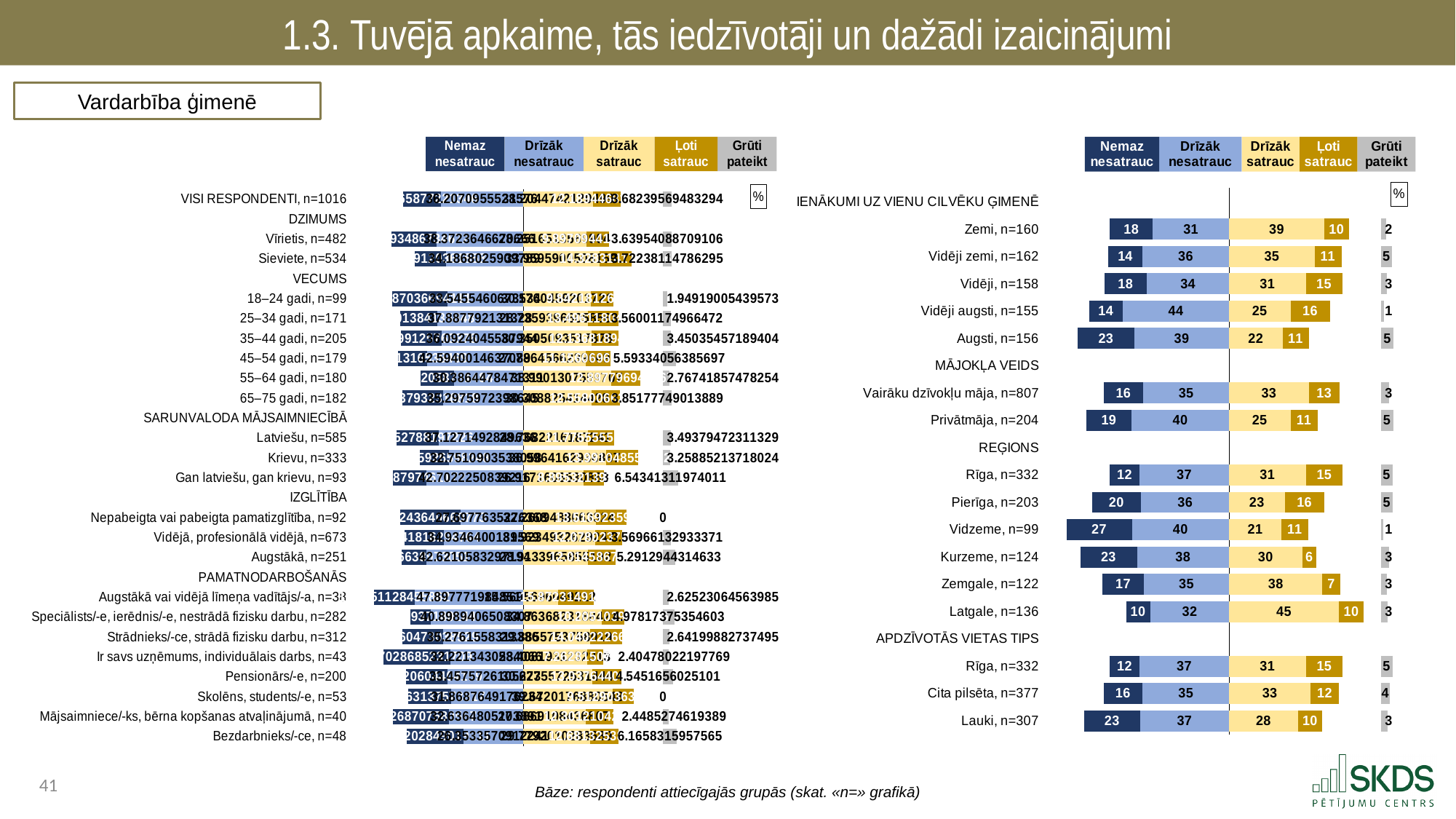
In the right-hand chart, which has the larger 'Nemaz nesatrauc' value: Privātmāja, n=204 or Vairāku dzīvokļu māja, n=807? Privātmāja, n=204 In the right-hand chart, what is the 'Nemaz nesatrauc' value for Vidzeme, n=99? 27 In the right-hand chart, what is the 'Drīzāk satrauc' value for Latgale, n=136? 45 In the right-hand chart, what is the 'Ļoti satrauc' value for Pierīga, n=203? 16 In the right-hand chart, what is the difference between the 'Drīzāk nesatrauc' values for Vidēji augsti, n=155 and Zemi, n=160? 13 How many categories are shown under APDZĪVOTĀS VIETAS TIPS in the right-hand chart? 3 In the right-hand chart, which region under REĢIONS has the lowest 'Nemaz nesatrauc' value? Latgale, n=136 In the right-hand chart, which region under REĢIONS has the highest 'Drīzāk satrauc' value? Latgale, n=136 What kind of chart is the right-hand chart? Stacked bar chart In the right-hand chart, what is the total of the stacked bar for Zemi, n=160? 100 In the right-hand chart, what is the 'Grūti pateikt' value for Cita pilsēta, n=377? 4 How many series does the legend of the right-hand chart list? 5